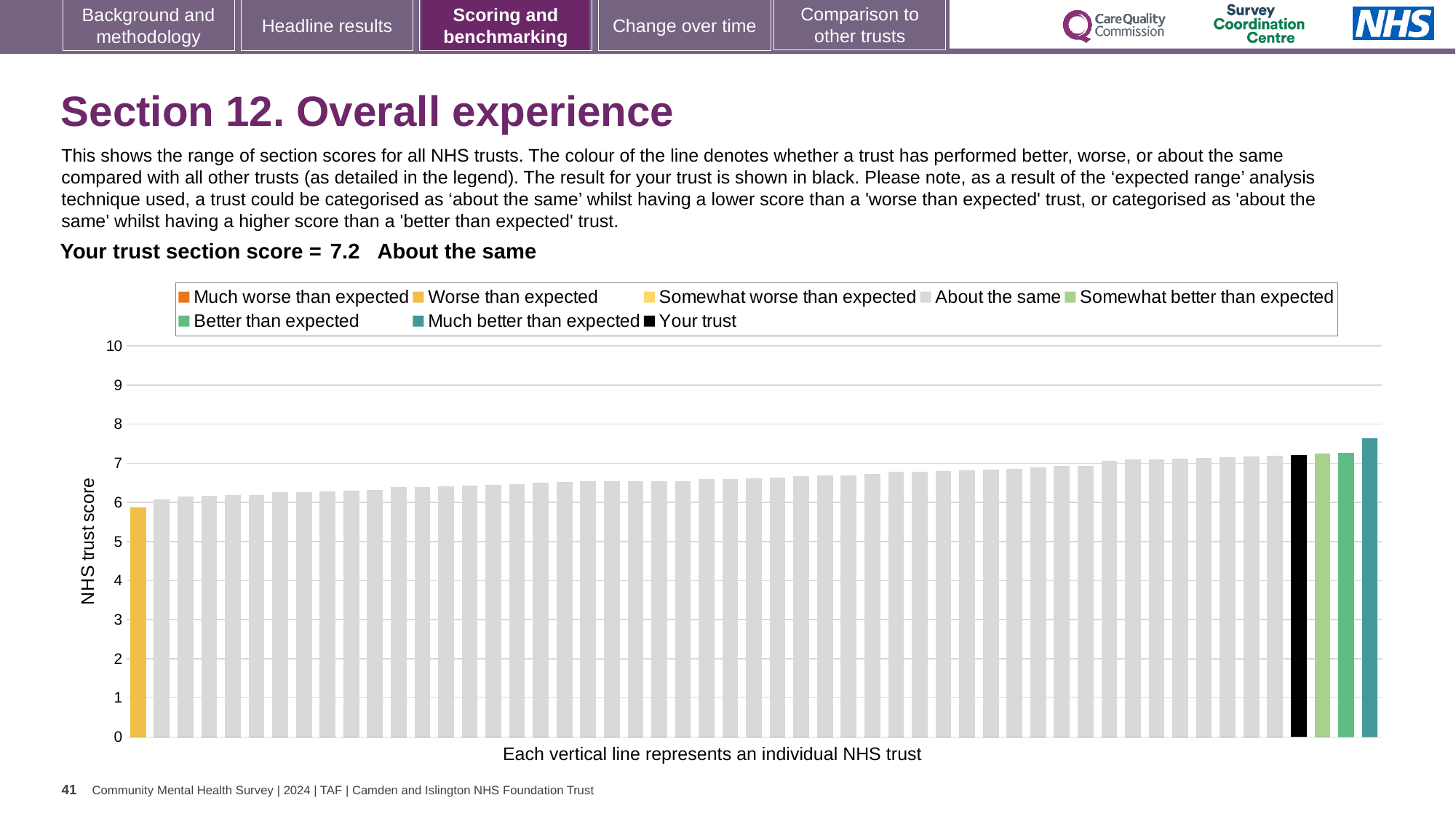
How many entries does the chart legend list? 8 Which legend category does the tallest bar in the chart belong to? Much better than expected What is the section score for your trust shown on the slide? 7.2 Is the value of the tallest bar greater or less than 8? less Which is larger: the value for your trust (black bar) or the value for the yellow 'Worse than expected' bar? your trust How is your trust categorised compared with other trusts, according to the text above the chart? About the same Is the value for the yellow 'Worse than expected' bar greater or less than 6? less What is the label on the vertical axis of the chart? NHS trust score Which legend category does the shortest bar in the chart belong to? Worse than expected Is the value for your trust (the black bar) greater or less than 7? greater Do the bar values rise or fall from left to right along the x axis? rise What kind of chart is shown on the slide? bar chart